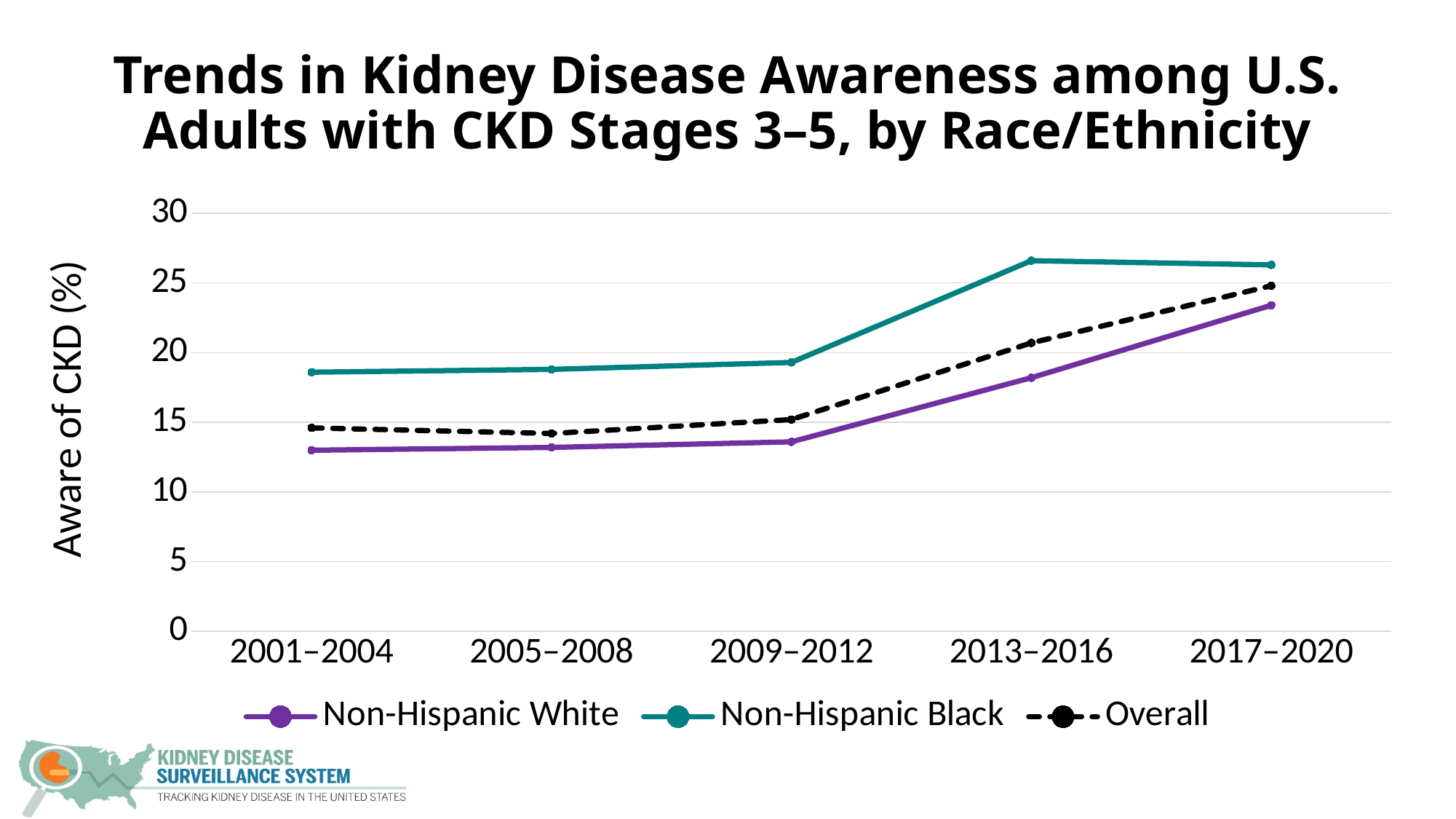
Which series has the lowest value in 2001–2004? Non-Hispanic White What kind of chart is shown on the slide? line chart How many time periods are shown on the x axis? 5 In 2013–2016, which is larger: Non-Hispanic Black or Non-Hispanic White? Non-Hispanic Black Is the value for Non-Hispanic White in 2001–2004 greater or less than 15? less Is the value for Non-Hispanic White in 2017–2020 greater or less than 20? greater How many series does the legend list? 3 Does the Non-Hispanic White series generally rise or fall from 2001–2004 to 2017–2020? rise Is the value for Non-Hispanic Black in 2001–2004 greater or less than 20? less In which time period is the Non-Hispanic White series highest? 2017–2020 What is the label on the y axis? Aware of CKD (%)